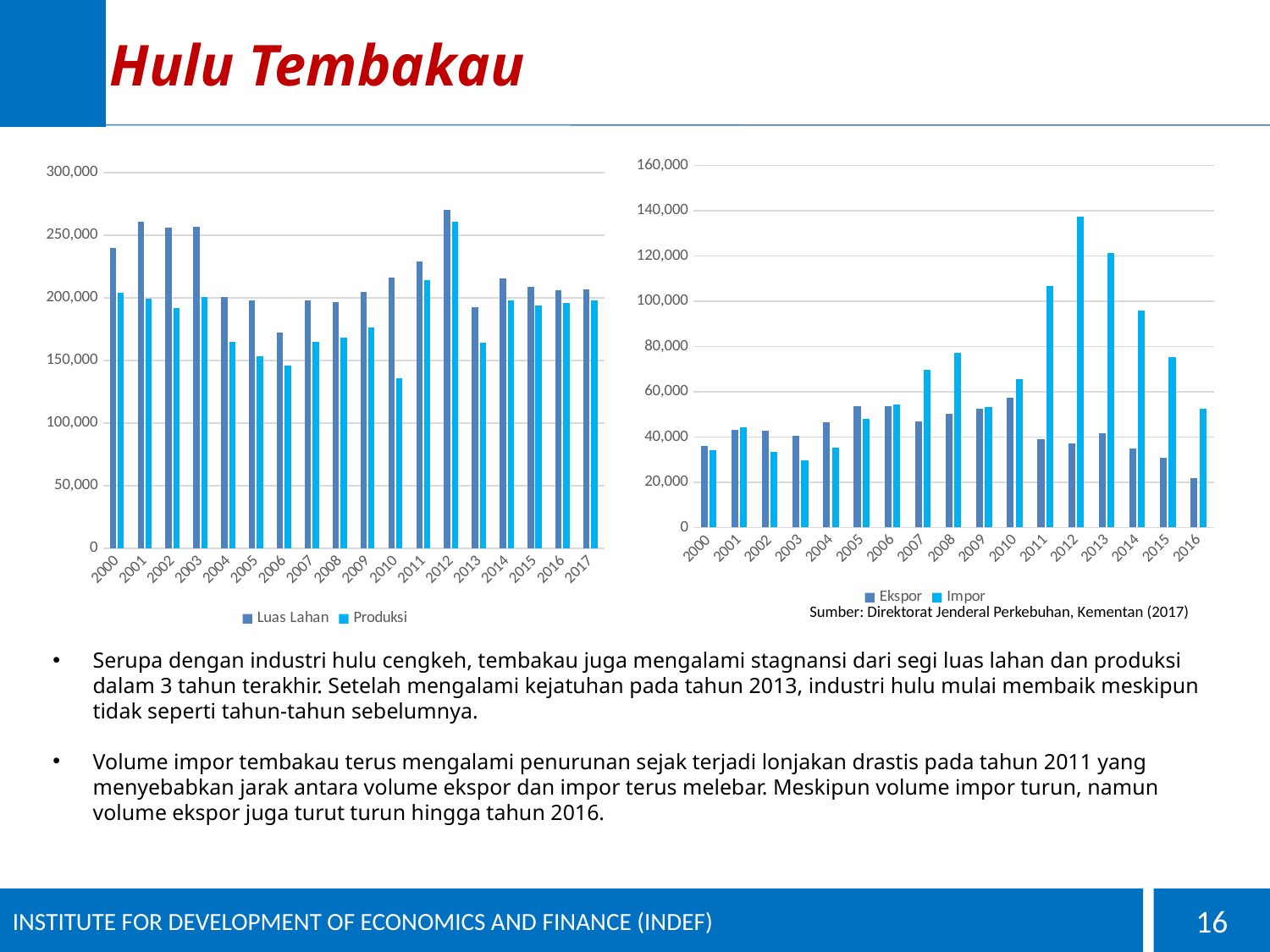
How many years are shown on the x axis of the right chart? 17 How many years are shown on the x axis of the left chart? 18 In the left chart, is the Produksi value for 2010 greater or less than 150,000? less In the right chart, which year has the highest Impor value? 2012 In the right chart, is the Impor value for 2012 greater or less than 120,000? greater In the right chart, do the Impor values rise or fall from 2012 to 2016? fall In the right chart, which year has the lowest Ekspor value? 2016 In the right chart, which is larger in 2011, Ekspor or Impor? Impor How many series does the legend of the right chart list? 2 In the left chart, which year has the highest Luas Lahan value? 2012 What kind of chart is the left chart (Luas Lahan / Produksi)? bar chart In the left chart, which year has the lowest Produksi value? 2010